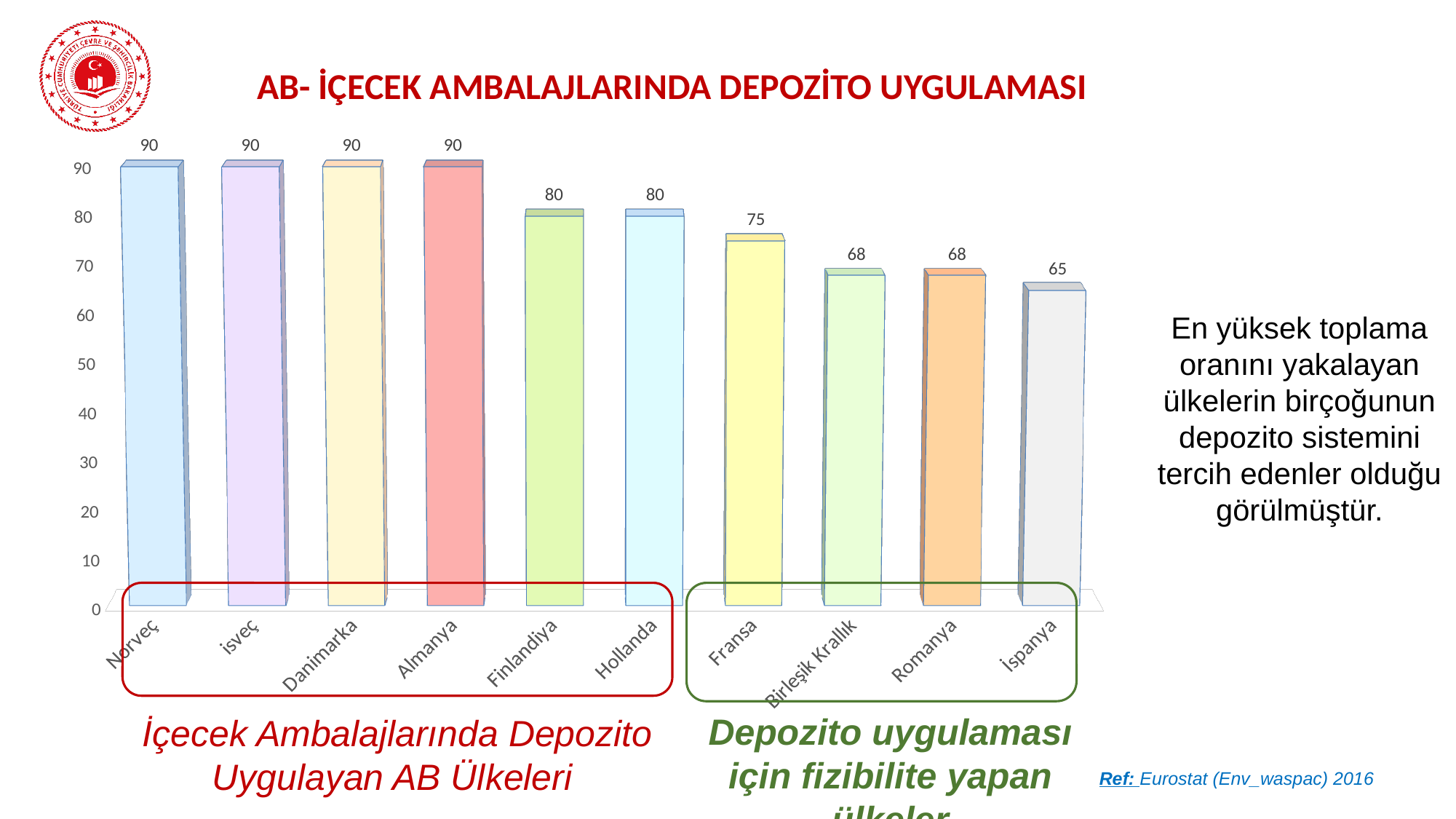
What kind of chart is shown on the slide? bar chart What is the difference between the values for Finlandiya and İspanya? 15 What is the value for Hollanda? 80 What is the value for Birleşik Krallık? 68 What is the difference between the values for Almanya and Fransa? 15 How many countries share the highest value of 90? 4 Which country has the lowest value? İspanya What is the value for İspanya? 65 Which is larger, the value for Hollanda or the value for Romanya? Hollanda What is the value for Fransa? 75 Do the values rise or fall from left to right along the x axis? fall How many countries are shown on the chart? 10